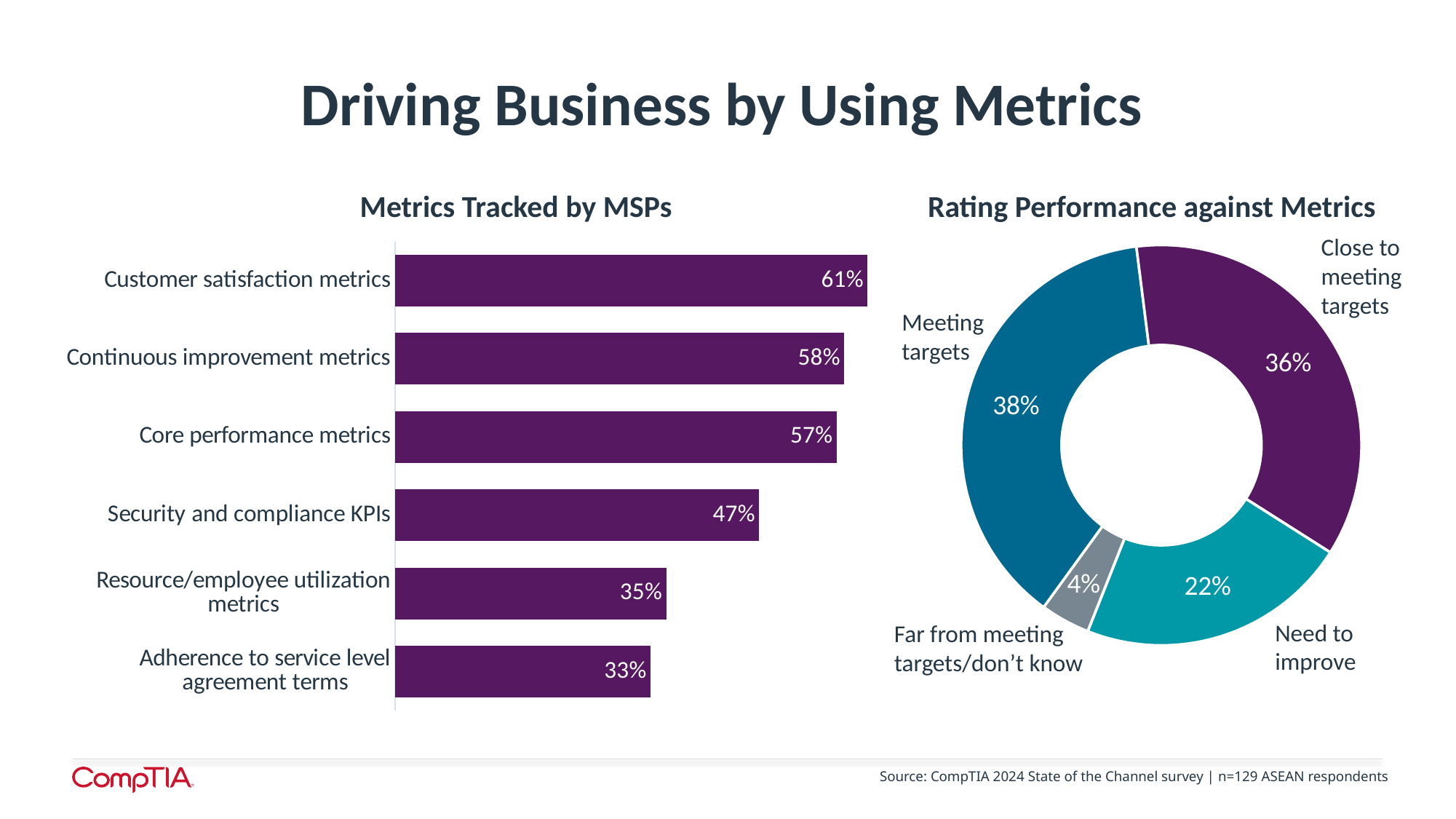
What type of chart is 'Rating Performance against Metrics'? Doughnut chart In the 'Rating Performance against Metrics' chart, which category has the smallest share? Far from meeting targets/don't know In the 'Rating Performance against Metrics' chart, which is larger: 'Meeting targets' or 'Close to meeting targets'? Meeting targets In the 'Metrics Tracked by MSPs' chart, how many metrics are listed? 6 In the 'Rating Performance against Metrics' chart, what percentage say they need to improve? 22% In the 'Rating Performance against Metrics' chart, what share of respondents are meeting targets? 38% In the 'Metrics Tracked by MSPs' chart, what percentage of MSPs track customer satisfaction metrics? 61% In the 'Metrics Tracked by MSPs' chart, which metric has the lowest percentage? Adherence to service level agreement terms In the 'Metrics Tracked by MSPs' chart, what is the difference between Core performance metrics and Resource/employee utilization metrics? 22 percentage points In the 'Metrics Tracked by MSPs' chart, what is the value for Security and compliance KPIs? 47% What type of chart is 'Metrics Tracked by MSPs'? Bar chart In the 'Metrics Tracked by MSPs' chart, which metric has the highest percentage? Customer satisfaction metrics